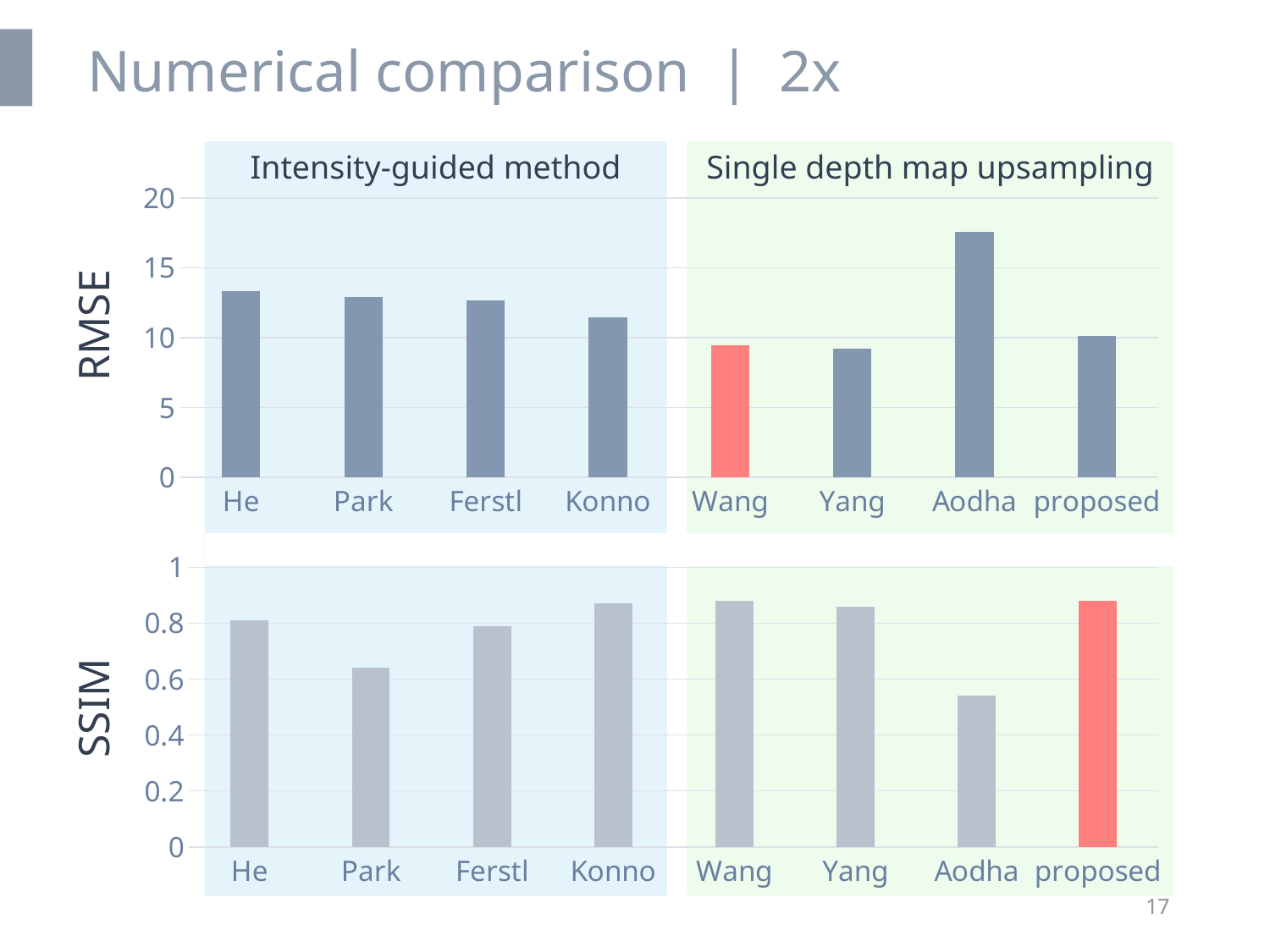
In the RMSE chart, which method has the highest RMSE? Aodha In the SSIM chart, which method has the lowest SSIM? Aodha In the RMSE chart, which has the larger RMSE, He or Konno? He In the SSIM chart, is the value for Konno greater or less than 0.8? greater What kind of chart is the RMSE chart at the top of the slide? bar chart In the RMSE chart, is the value for He greater or less than 10? greater In the RMSE chart, is the value for Aodha greater or less than 15? greater In the SSIM chart, which has the larger SSIM, Park or Konno? Konno In the SSIM chart, which method's bar is highlighted in red? proposed How many methods are plotted in the RMSE chart? 8